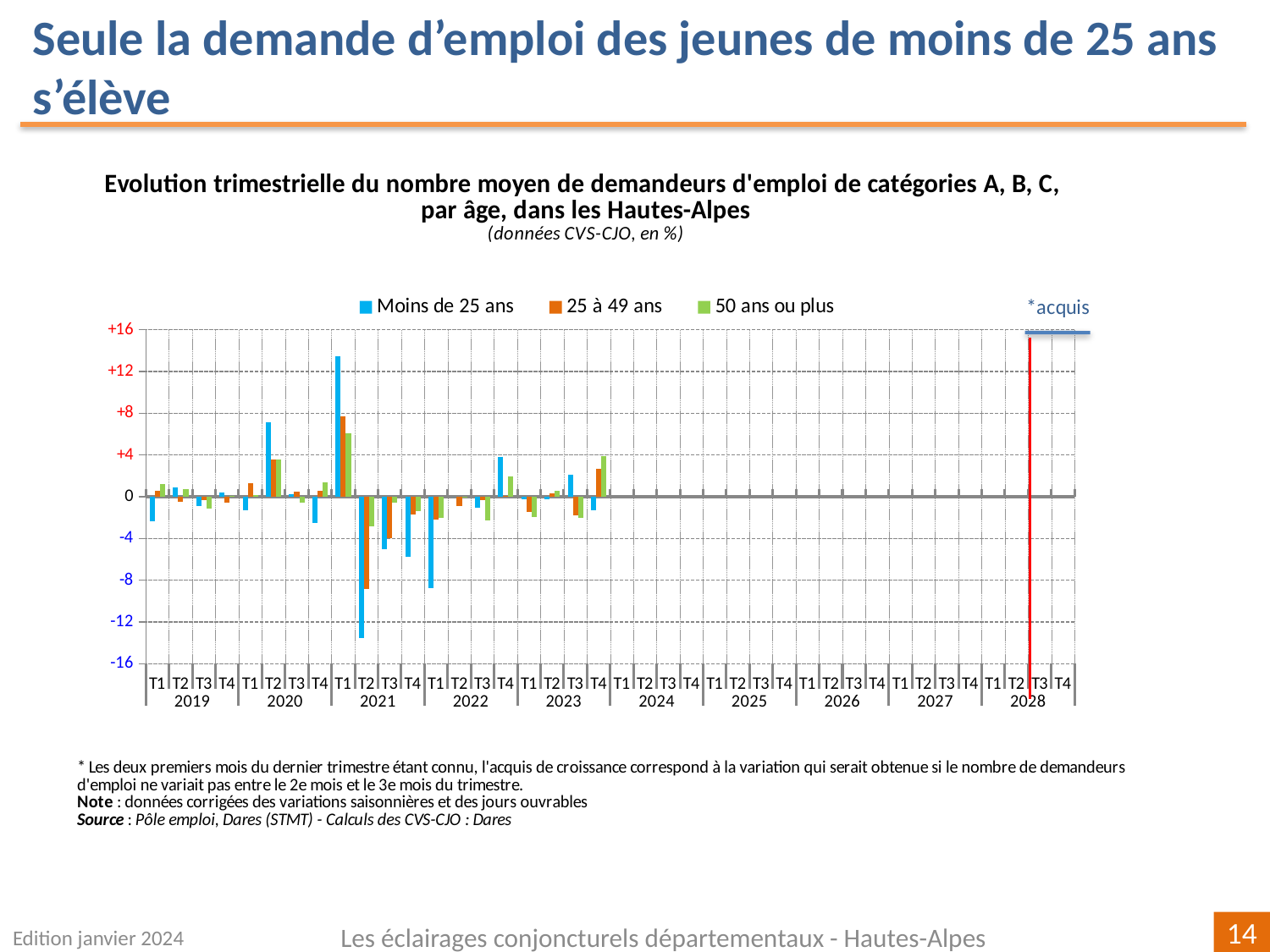
Is the value for '25 à 49 ans' in T2 2021 greater or less than -8? less Which series is shown in blue in the legend? Moins de 25 ans Which is larger for the 'Moins de 25 ans' series: the value in T1 2021 or the value in T2 2020? T1 2021 In which quarter does the 'Moins de 25 ans' series reach its highest value? T1 2021 Is the value for 'Moins de 25 ans' in T1 2021 greater or less than +12? greater Which series is shown in orange in the legend? 25 à 49 ans Is the value for 'Moins de 25 ans' in T2 2020 greater or less than +4? greater What kind of chart is shown on the slide? bar chart In which quarter does the 'Moins de 25 ans' series reach its lowest value? T2 2021 How many series does the legend list? 3